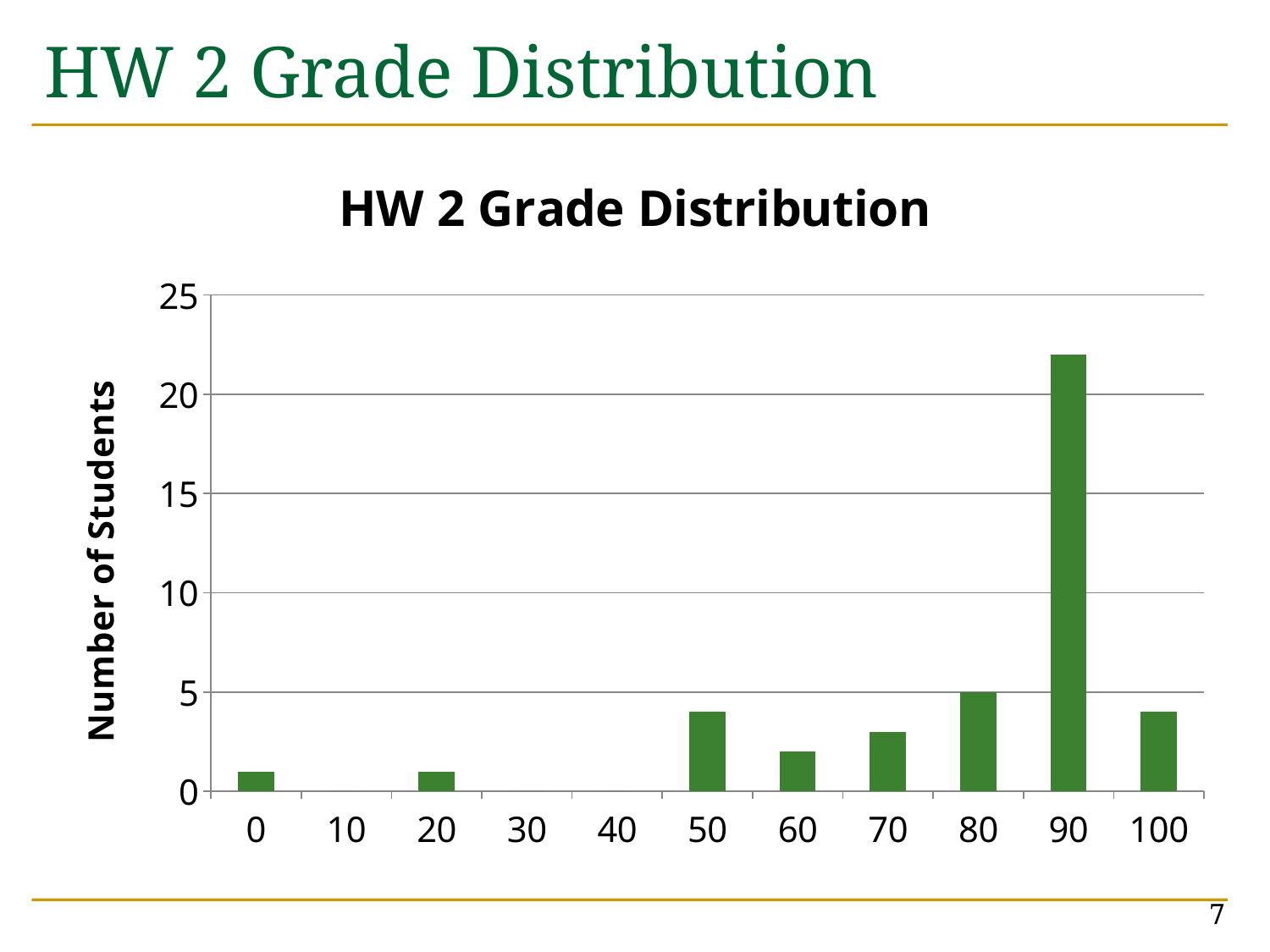
How many students are in the 10 grade category? 0 What kind of chart is shown on the slide? bar chart Which grade category has the highest number of students? 90 Which has more students, the 90 grade category or the 80 grade category? 90 Is the number of students in the 90 grade category greater or less than 20? greater Is the number of students in the 50 grade category greater or less than 5? less Is the number of students in the 100 grade category greater or less than 5? less Which has more students, the 50 grade category or the 60 grade category? 50 How many students are in the 80 grade category? 5 What is the title of the chart? HW 2 Grade Distribution What is the label on the vertical axis of the chart? Number of Students How many grade categories are shown along the x axis? 11